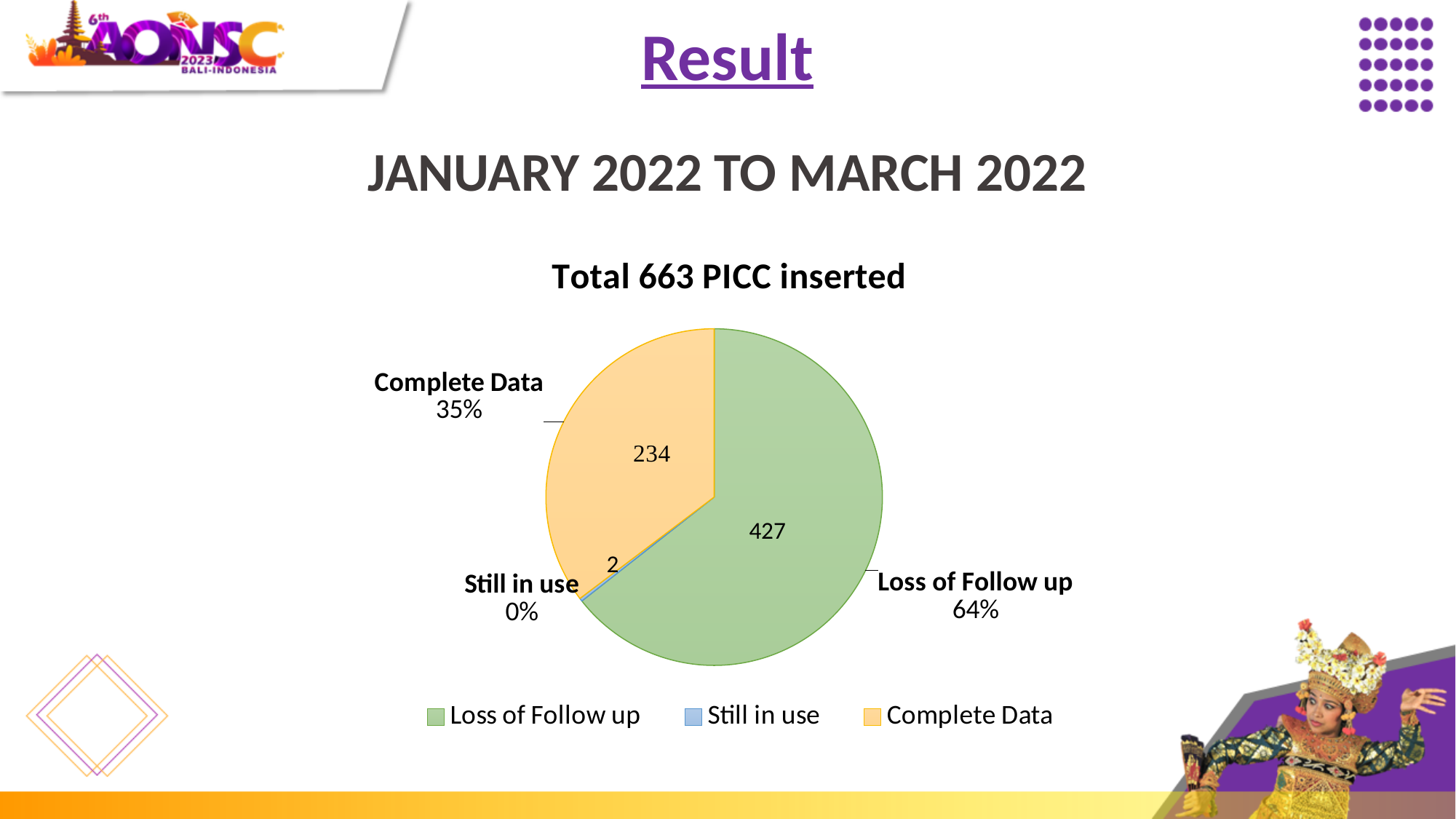
What is the difference between the values for Loss of Follow up and Complete Data? 193 Which category has the largest slice? Loss of Follow up What percentage share of the pie is Complete Data? 35% How many entries does the legend list? 3 What is the value for Still in use? 2 What is the value for Loss of Follow up? 427 What percentage share of the pie is Loss of Follow up? 64% How many slices does the pie chart have? 3 What is the value for Complete Data? 234 Which category has the smallest slice? Still in use What is the title of the chart? Total 663 PICC inserted What type of chart is shown on the slide? pie chart